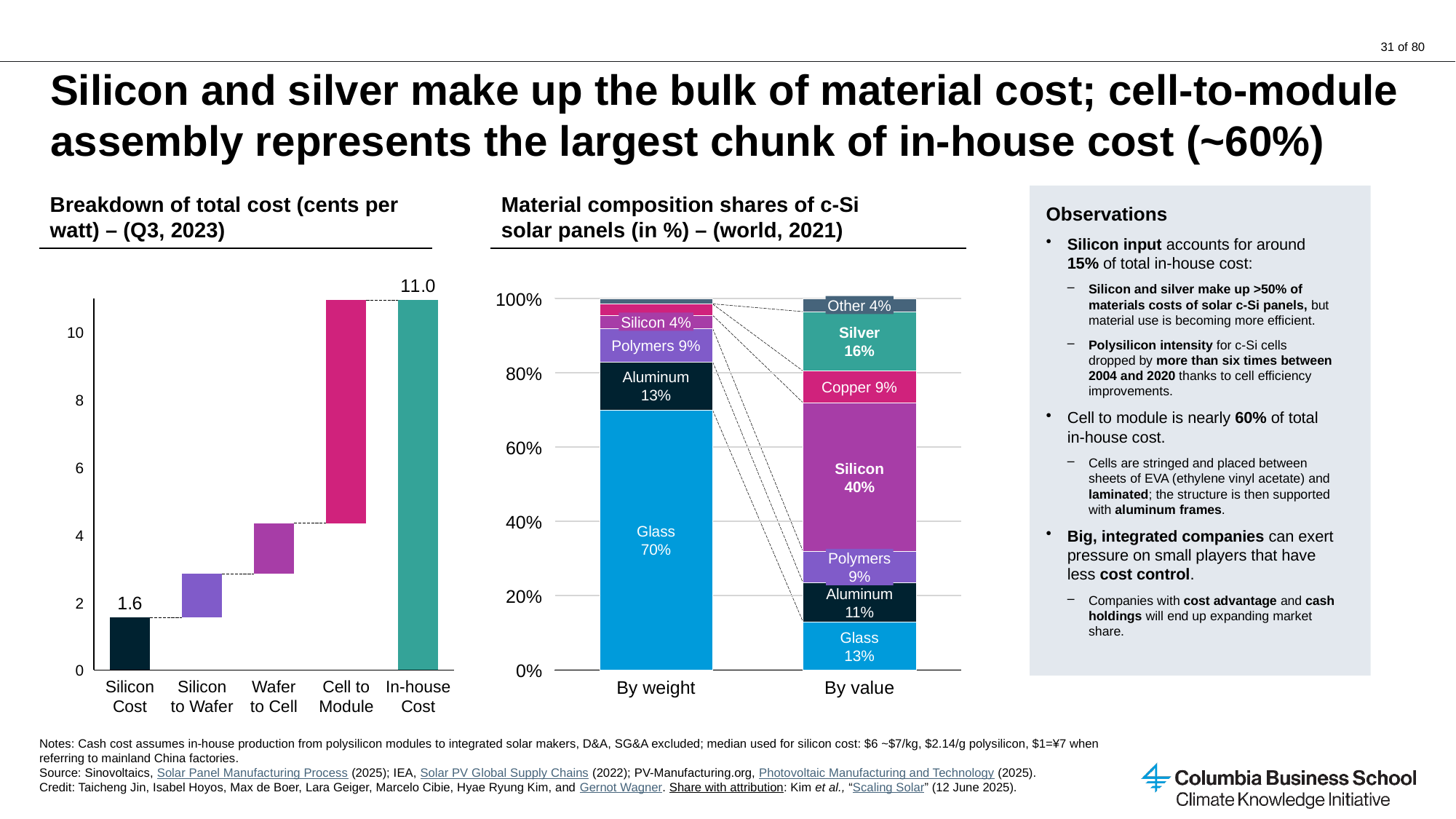
In the 'Material composition shares of c-Si solar panels' chart, is the share of Glass larger by weight or by value? By weight In the 'Breakdown of total cost (cents per watt)' chart, what is the difference between the In-house Cost and the Silicon Cost values? 9.4 In the 'Material composition shares of c-Si solar panels' chart, which material has the largest share by value? Silicon In the 'Breakdown of total cost (cents per watt)' chart, what is the value shown for In-house Cost? 11.0 In the 'Material composition shares of c-Si solar panels' chart, what share does Silicon have by value? 40% In the 'Material composition shares of c-Si solar panels' chart, how many labelled segments make up the 'By value' bar? 7 In the 'Material composition shares of c-Si solar panels' chart, what share does Glass have by weight? 70% In the 'Breakdown of total cost (cents per watt)' chart, what is the value shown for Silicon Cost? 1.6 What kind of chart is the 'Breakdown of total cost (cents per watt)' chart? Bar chart In the 'Material composition shares of c-Si solar panels' chart, how many percentage points higher is Silicon's share by value than by weight? 36 In the 'Material composition shares of c-Si solar panels' chart, what share does Silver have by value? 16% How many categories are shown on the x axis of the 'Breakdown of total cost (cents per watt)' chart? 5